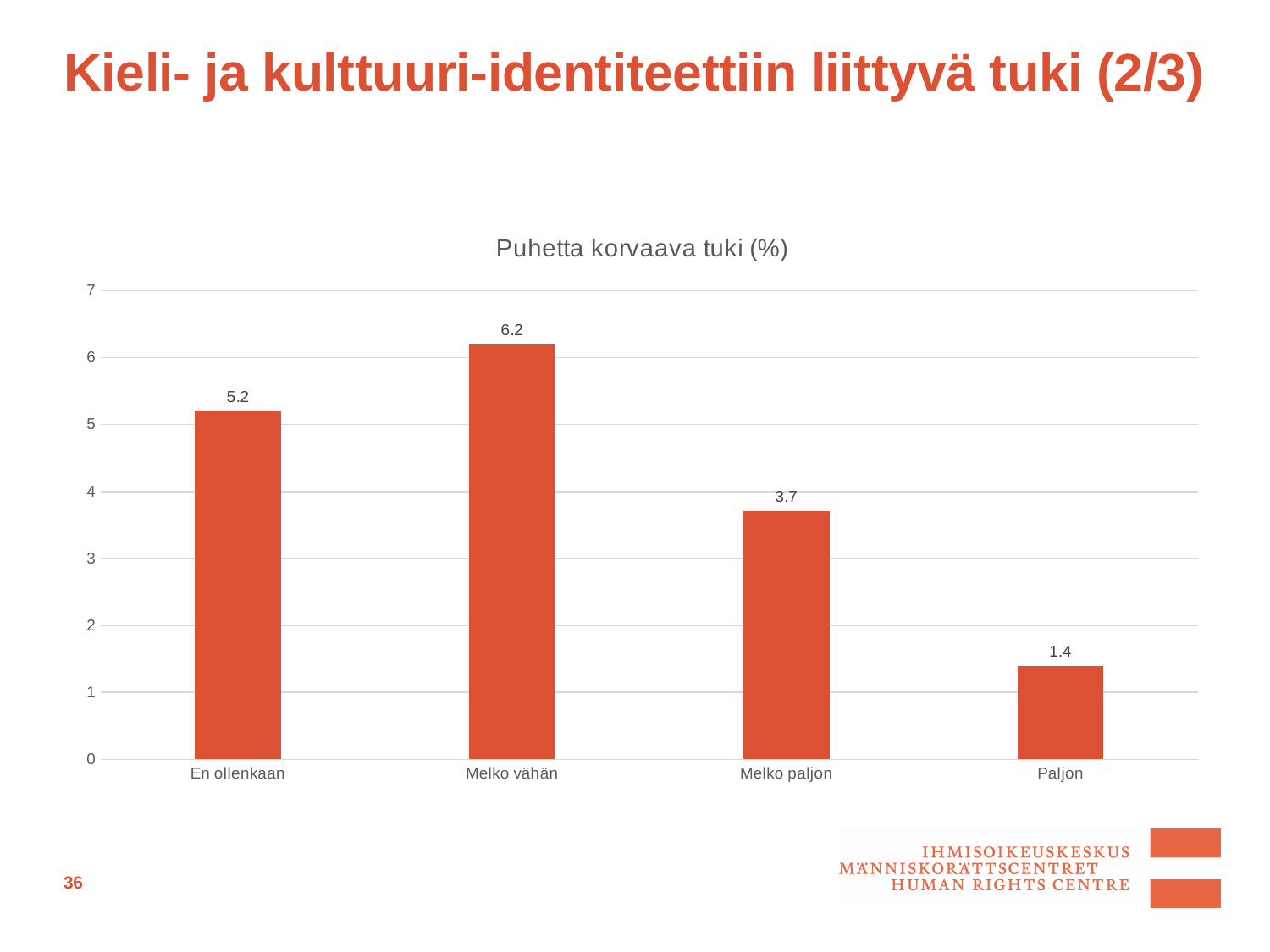
Which is larger, the value for En ollenkaan or the value for Melko paljon? En ollenkaan What is the difference between the values for Melko paljon and Paljon? 2.3 What is the value for En ollenkaan? 5.2 Which category has the highest value? Melko vähän Which category has the lowest value? Paljon How many categories are shown on the x axis? 4 What is the difference between the values for Melko vähän and En ollenkaan? 1.0 What is the value for Melko paljon? 3.7 What is the value for Melko vähän? 6.2 What kind of chart is shown on the slide? bar chart What is the title of the chart? Puhetta korvaava tuki (%) What is the value for Paljon? 1.4